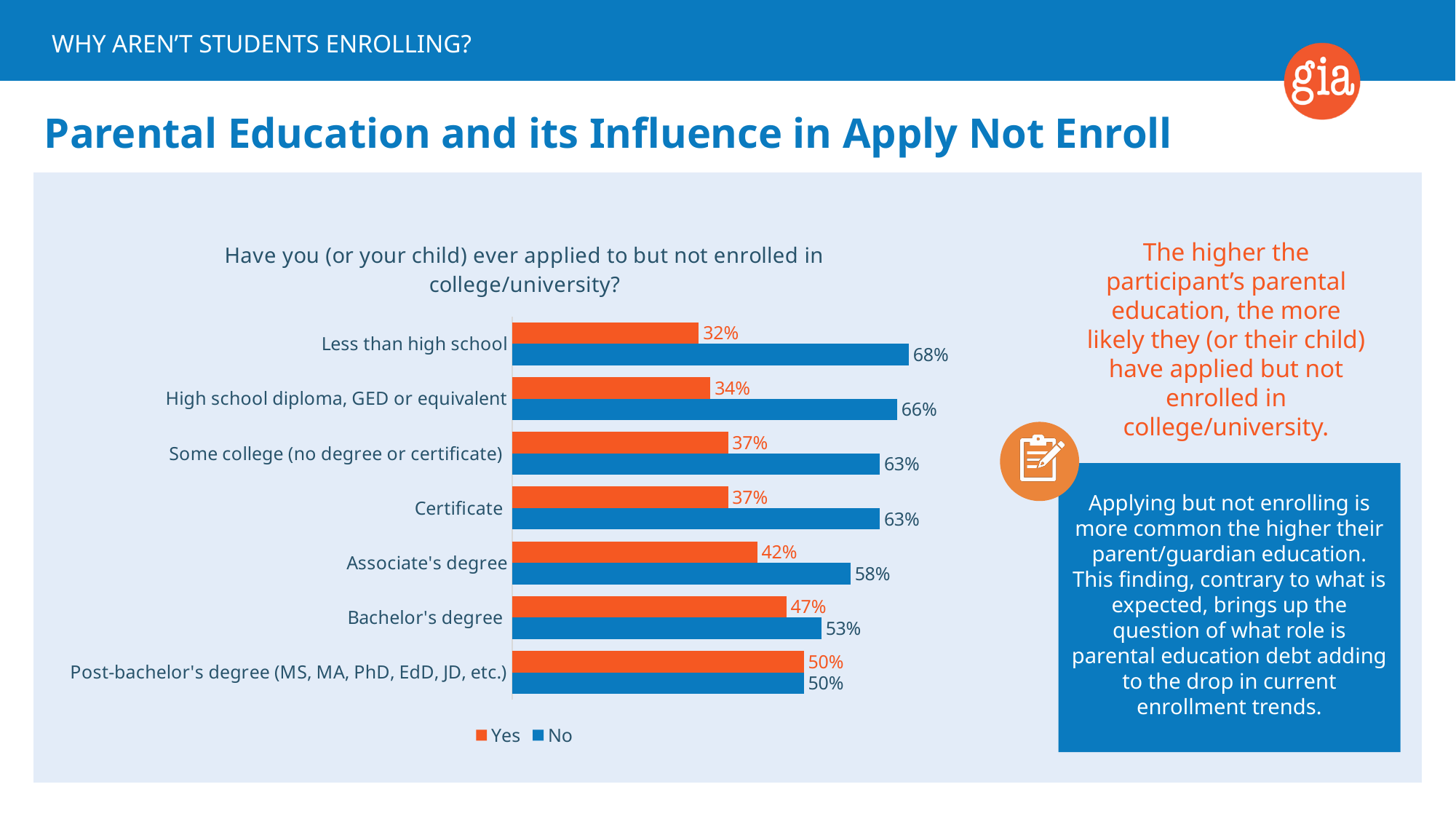
Which is larger for Certificate, the "Yes" value or the "No" value? No What is the "No" value for Associate's degree? 58% What kind of chart is shown on the slide? Bar chart What is the "Yes" value for Less than high school? 32% What is the difference between the "No" and "Yes" values for High school diploma, GED or equivalent? 32% Which category has the highest "Yes" value? Post-bachelor's degree (MS, MA, PhD, EdD, JD, etc.) Which colour represents the "Yes" series in the chart? Orange How many parental education categories are shown in the chart? 7 Which category has the lowest "Yes" value? Less than high school What is the "Yes" value for Bachelor's degree? 47% Which category has the highest "No" value? Less than high school How many series does the legend list? 2